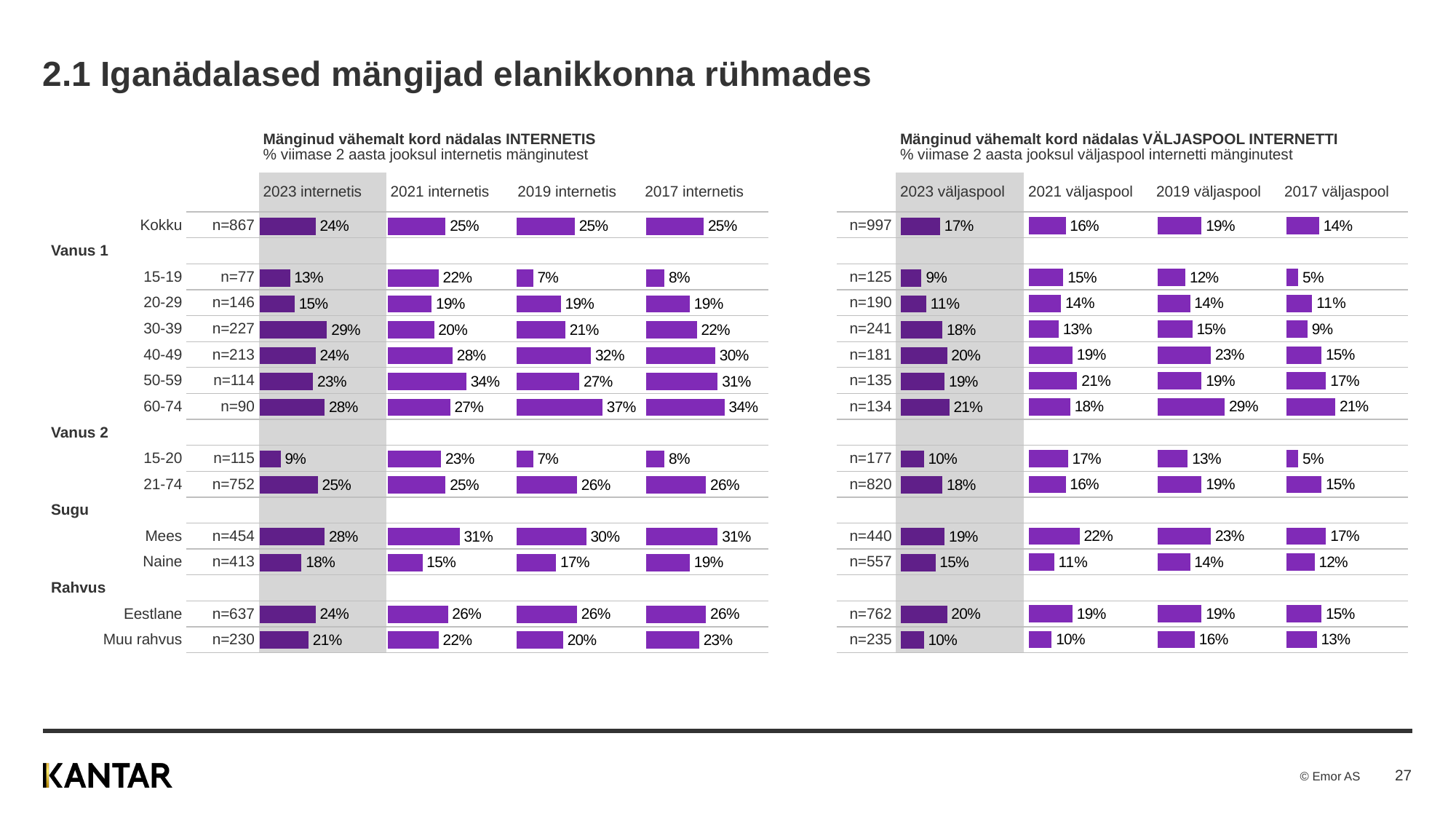
In the 'Mänginud vähemalt kord nädalas INTERNETIS' chart, what is the difference between the 2023 internetis values for Mees and Naine? 10 percentage points In the 'Mänginud vähemalt kord nädalas VÄLJASPOOL INTERNETTI' chart, what is the sample size (n) for Kokku? n=997 In the 'Mänginud vähemalt kord nädalas INTERNETIS' chart, how does the 2023 internetis value for the 15-20 age group compare to the 2021 internetis value for the same group? 2021 internetis is larger In the 'Mänginud vähemalt kord nädalas INTERNETIS' chart, what is the 2019 internetis value for the 15-19 age group? 7% In the 'Mänginud vähemalt kord nädalas INTERNETIS' chart, what is the 2023 internetis value for Kokku? 24% In the 'Mänginud vähemalt kord nädalas INTERNETIS' chart, what is the difference between the 2019 internetis and 2023 internetis values for the 60-74 age group? 9 percentage points In the 'Mänginud vähemalt kord nädalas VÄLJASPOOL INTERNETTI' chart, what is the 2019 väljaspool value for the 60-74 age group? 29% What kind of chart is used on the slide to show the percentages? Bar chart In the 'Mänginud vähemalt kord nädalas INTERNETIS' chart, which Vanus 1 age group has the highest 2023 internetis value? 30-39 In the 'Mänginud vähemalt kord nädalas VÄLJASPOOL INTERNETTI' chart, which is larger for Eestlane: the 2023 väljaspool value or the 2017 väljaspool value? 2023 väljaspool In the 'Mänginud vähemalt kord nädalas VÄLJASPOOL INTERNETTI' chart, which Vanus 1 age group has the lowest 2023 väljaspool value? 15-19 How many year columns does each of the two charts on the slide show? 4